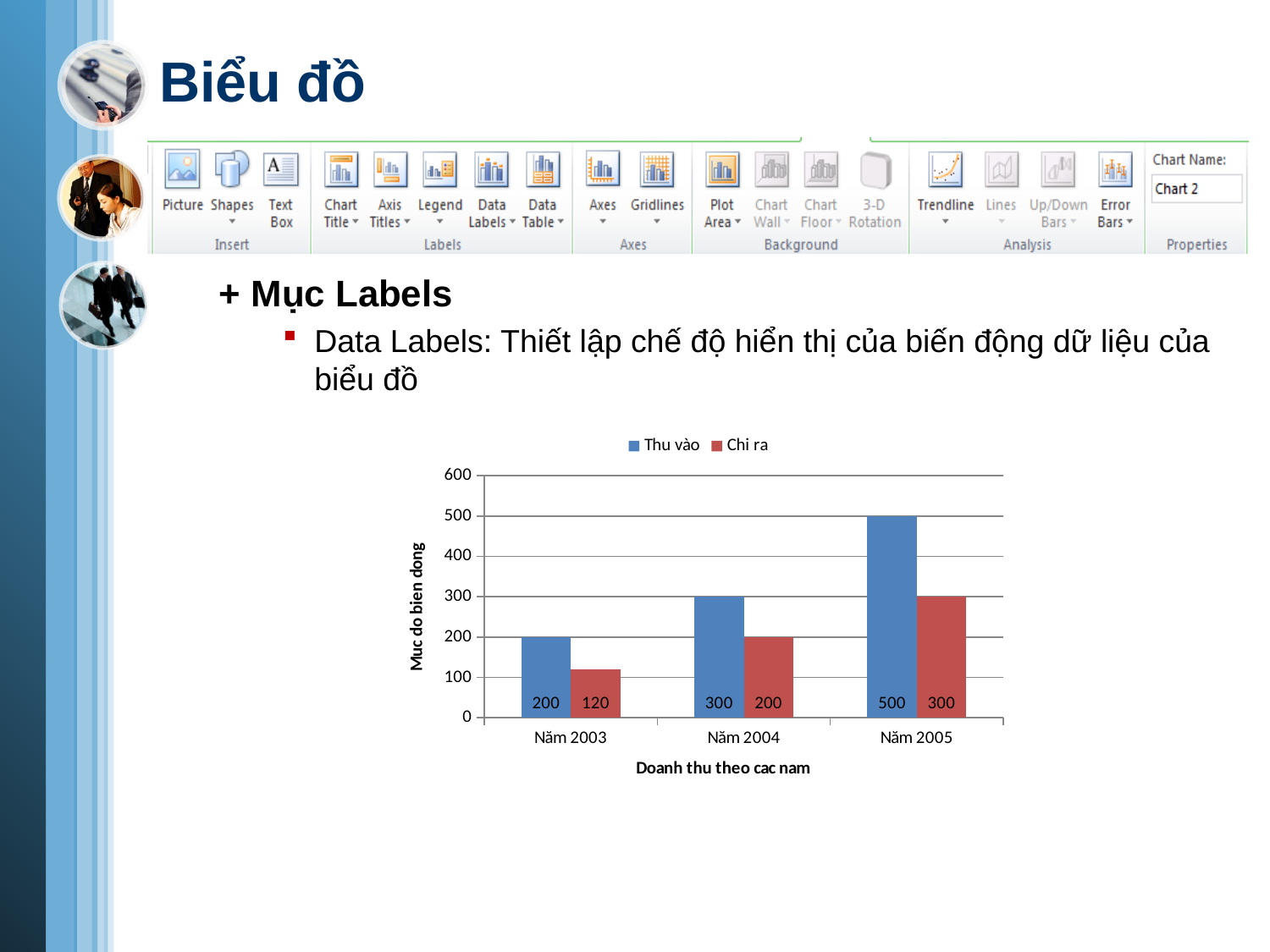
What kind of chart is shown on the slide? Bar chart What is the value of Thu vào for Năm 2004? 300 What is the difference between Thu vào and Chi ra for Năm 2005? 200 What is the title of the vertical axis? Muc do bien dong Which year has the highest Thu vào value? Năm 2005 What is the value of Chi ra for Năm 2003? 120 How many years (categories) are shown on the x axis? 3 What is the value of Chi ra for Năm 2005? 300 Do the Thu vào values rise or fall from Năm 2003 to Năm 2005? Rise Which is larger for Năm 2004: Thu vào or Chi ra? Thu vào Which year has the lowest Chi ra value? Năm 2003 How many series does the legend list? 2